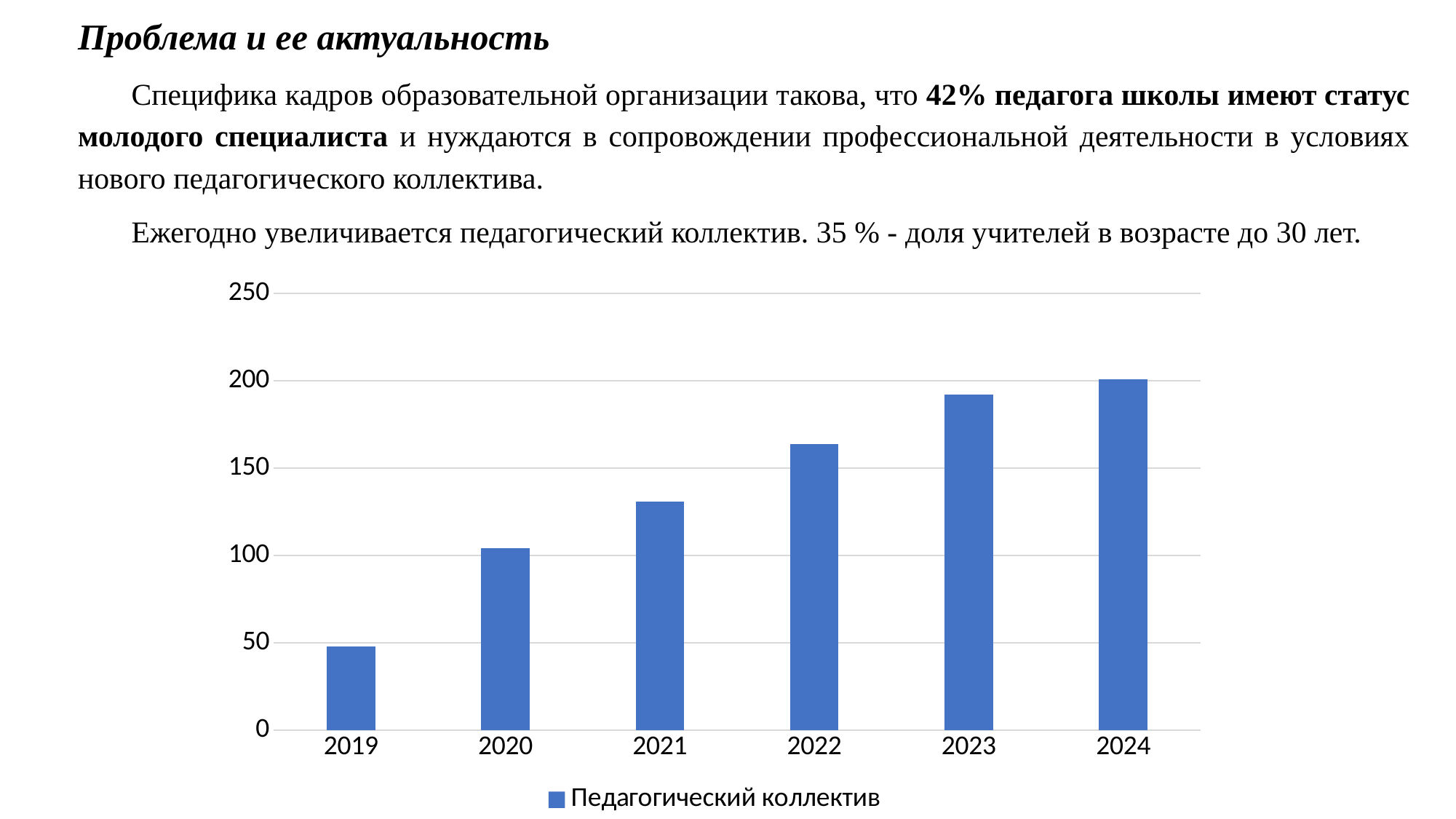
Is the value for 2022 greater or less than 150? greater Which year has the larger value, 2021 or 2022? 2022 How many series does the chart legend list? 1 Is the value for 2019 greater or less than 100? less What is the name of the series shown in the chart legend? Педагогический коллектив Is the value for 2023 greater or less than 200? less Do the values in the chart rise or fall from 2019 to 2024? rise Which year has the lowest value in the chart? 2019 How many years are shown on the x axis of the chart? 6 What kind of chart is shown on the slide? bar chart Which year has the highest value in the chart? 2024